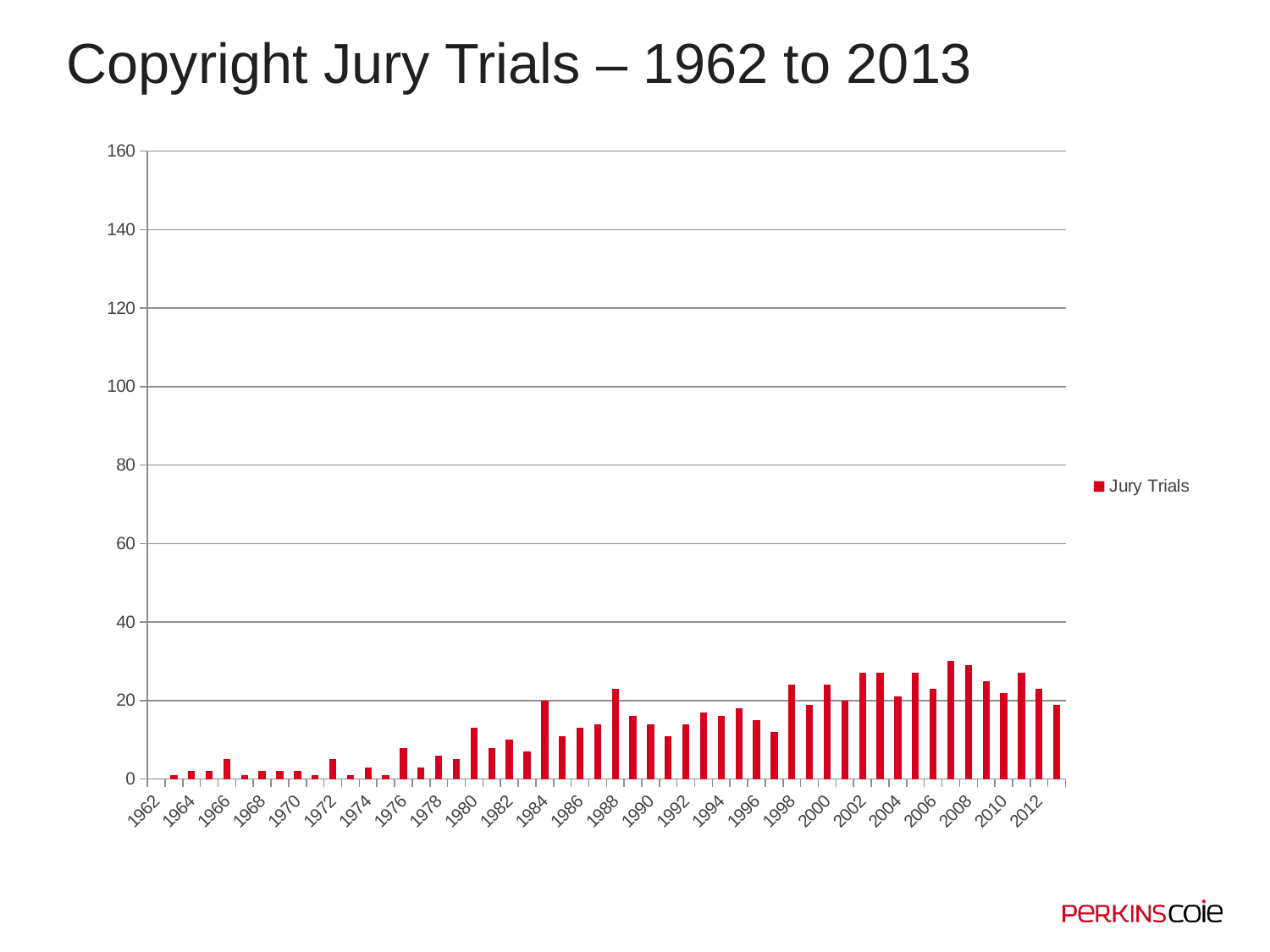
Which year has the larger value, 2007 or 1962? 2007 What is the name of the series shown in the legend? Jury Trials What kind of chart is shown on the slide? bar chart Overall, do the values rise or fall from 1962 to 2013? rise How many series does the legend list? 1 Is the value for 1962 greater or less than 20? less Is the value for 2008 greater or less than 20? greater Is the value for 2007 greater or less than 20? greater Which year has the larger value, 1984 or 1983? 1984 What is the title of the chart? Copyright Jury Trials – 1962 to 2013